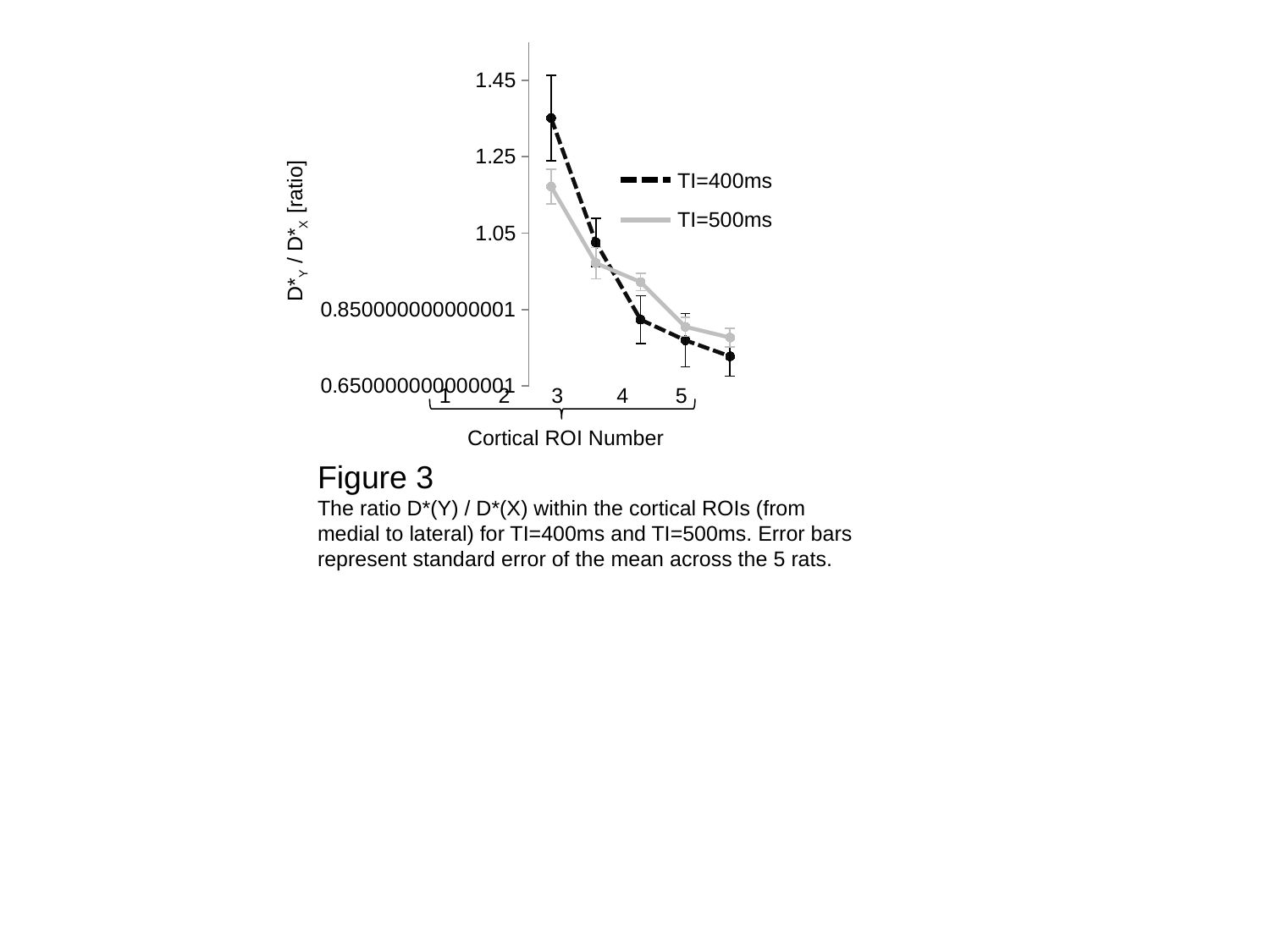
What are the two series named in the legend? TI=400ms and TI=500ms Do the values of the TI=400ms series rise or fall as the cortical ROI number increases? fall How many series does the legend list? 2 Is the first (leftmost) value of the TI=400ms series greater or less than 1.25? greater Do the values of the TI=500ms series rise or fall as the cortical ROI number increases? fall What is the title of the x axis? Cortical ROI Number Which series contains the highest plotted value on the chart? TI=400ms How many data points are plotted for the TI=400ms series? 5 What kind of chart is shown on the slide? line chart At the first (leftmost) point, which series has the higher value, TI=400ms or TI=500ms? TI=400ms Is the first (leftmost) value of the TI=500ms series greater or less than 1.25? less Is the last (rightmost) value of the TI=400ms series greater or less than 0.85? less